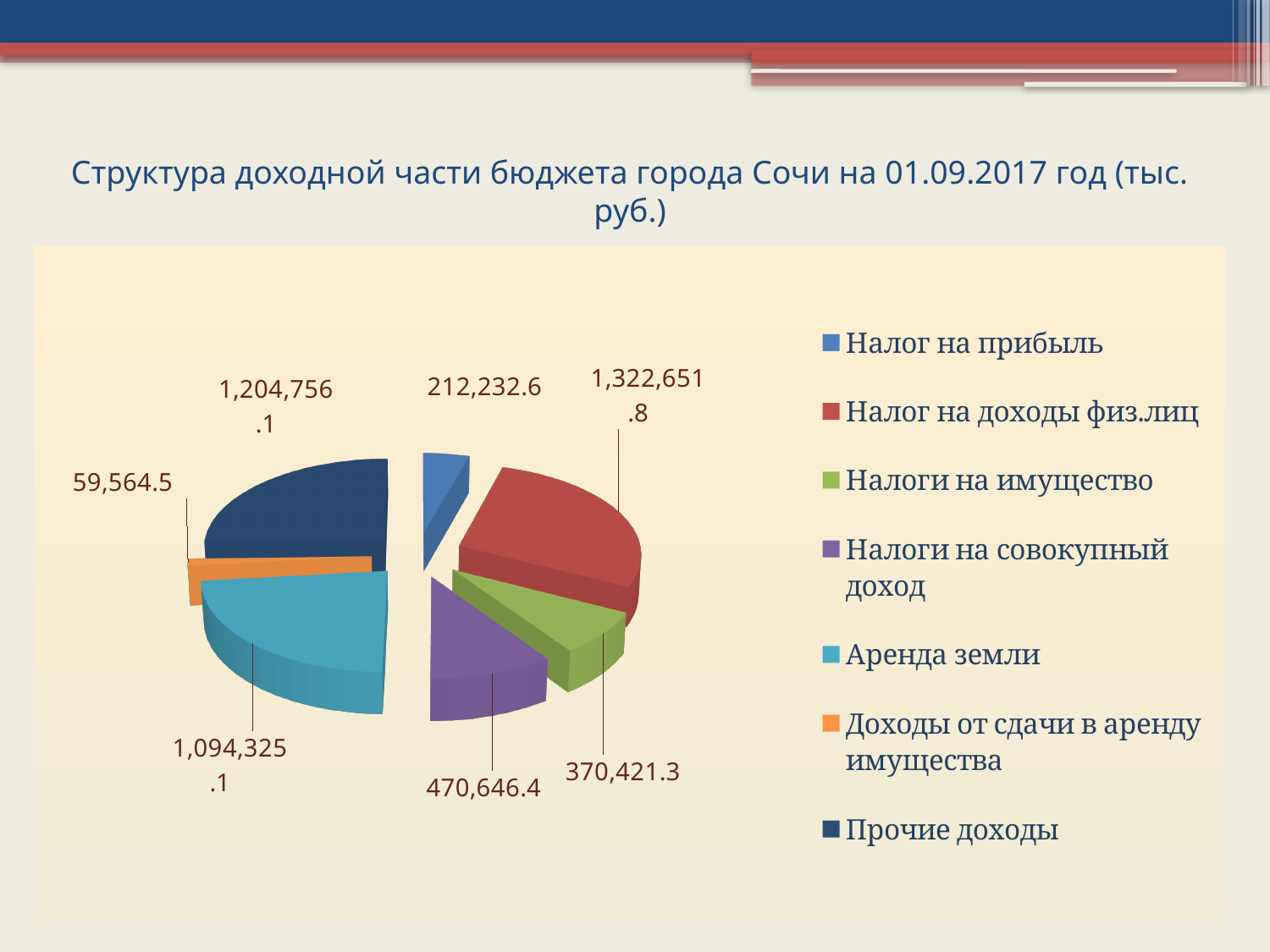
What is the difference between Налог на доходы физ.лиц and Прочие доходы? 117,895.7 Which category has the largest value? Налог на доходы физ.лиц What is the difference between Налоги на совокупный доход and Налоги на имущество? 100,225.1 How many categories does the pie chart show? 7 What colour is the slice for Налоги на имущество? Green What kind of chart is shown on the slide? Pie chart Which category has the smallest value? Доходы от сдачи в аренду имущества What is the value for Налоги на совокупный доход? 470,646.4 What is the value for Доходы от сдачи в аренду имущества? 59,564.5 What is the value for Аренда земли? 1,094,325.1 Which is larger, Аренда земли or Прочие доходы? Прочие доходы What is the value for Налог на доходы физ.лиц? 1,322,651.8